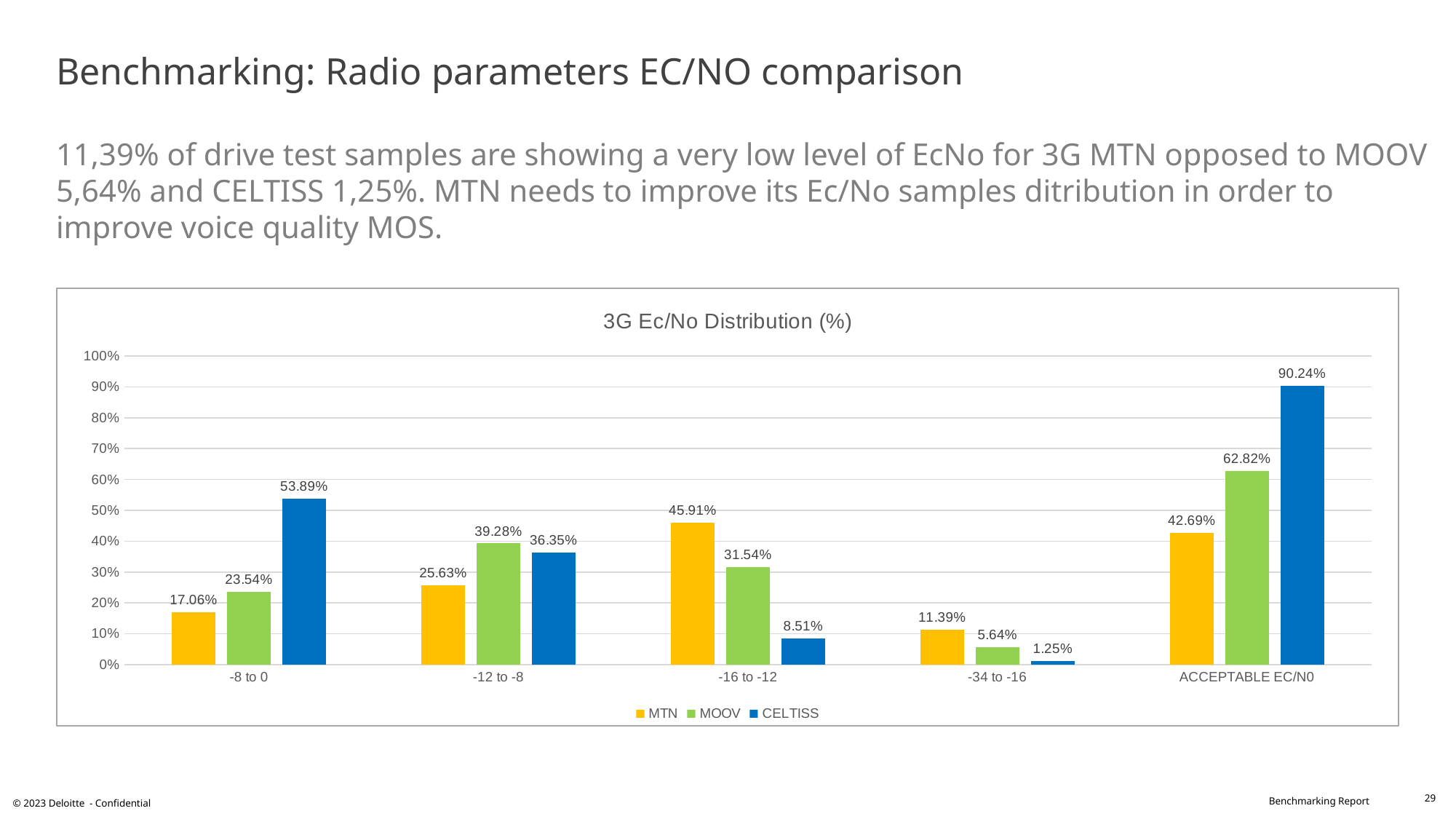
What is the difference between the CELTISS and MOOV values in the ACCEPTABLE EC/N0 category? 27.42% Which series has the highest value in the -16 to -12 category? MTN What is the value for MOOV in the -12 to -8 category? 39.28% How many categories are shown on the x axis? 5 What kind of chart is shown on the slide? bar chart What is the value for CELTISS in the ACCEPTABLE EC/N0 category? 90.24% Which is larger in the -12 to -8 category, the MOOV value or the CELTISS value? MOOV Which series has the lowest value in the -8 to 0 category? MTN What is the title of the chart? 3G Ec/No Distribution (%) Is the value for MTN in the ACCEPTABLE EC/N0 category greater or less than 50%? less How many series does the legend list? 3 What is the value for MTN in the -34 to -16 category? 11.39%